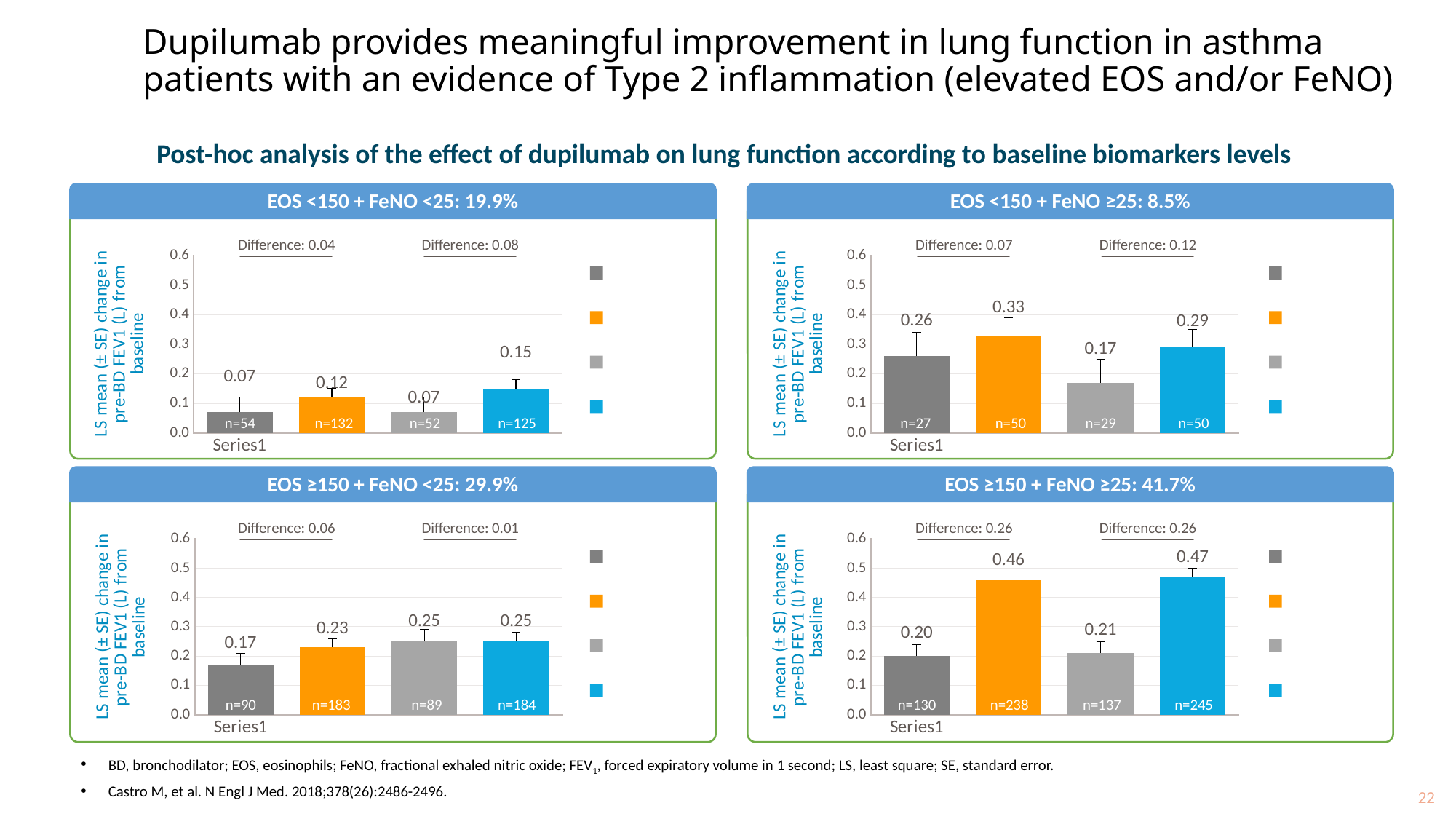
In the chart titled "EOS <150 + FeNO <25: 19.9%", what is the value of the blue bar labelled n=125? 0.15 What type of chart is used in the panel titled "EOS <150 + FeNO ≥25: 8.5%"? Bar chart In the chart titled "EOS ≥150 + FeNO ≥25: 41.7%", which bar has the highest value? The blue bar (n=245), 0.47 In the chart titled "EOS <150 + FeNO <25: 19.9%", which is larger: the orange bar (n=132) or the dark grey bar (n=54)? The orange bar (n=132) In the chart titled "EOS ≥150 + FeNO ≥25: 41.7%", what is the difference between the orange bar (n=238) and the dark grey bar (n=130)? 0.26 In the chart titled "EOS ≥150 + FeNO ≥25: 41.7%", is the value of the blue bar (n=245) greater or less than 0.4? greater In the chart titled "EOS ≥150 + FeNO <25: 29.9%", what is the value of the dark grey bar labelled n=90? 0.17 In the chart titled "EOS <150 + FeNO ≥25: 8.5%", what is the value of the orange bar labelled n=50? 0.33 What is the y-axis label of the chart titled "EOS ≥150 + FeNO ≥25: 41.7%"? LS mean (± SE) change in pre-BD FEV1 (L) from baseline In the chart titled "EOS ≥150 + FeNO <25: 29.9%", what is the difference annotated above the first two bars? Difference: 0.06 How many bars are plotted in the chart titled "EOS ≥150 + FeNO <25: 29.9%"? 4 In the chart titled "EOS <150 + FeNO ≥25: 8.5%", which bar has the lowest value? The light grey bar (n=29), 0.17